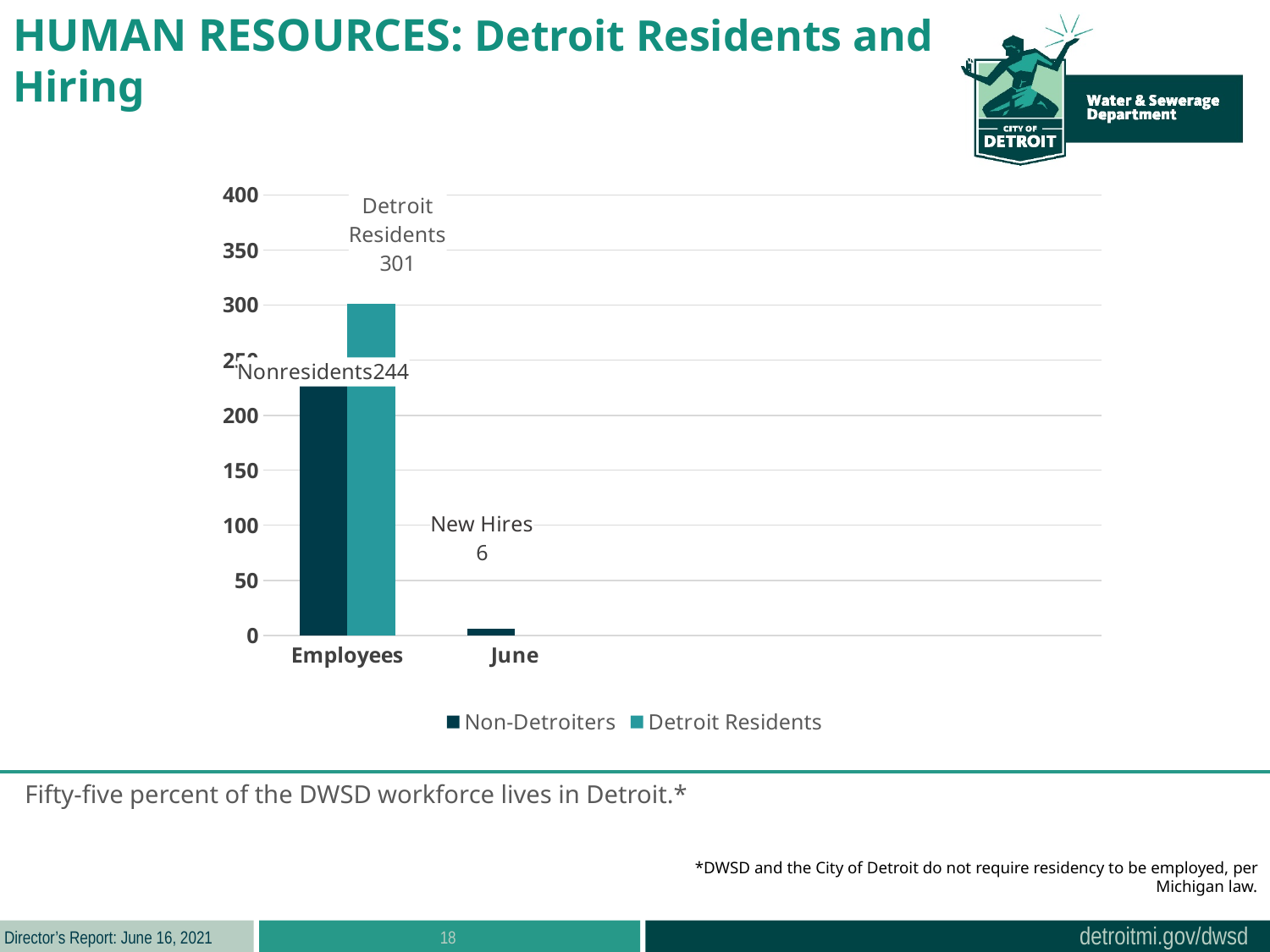
What are the two series named in the chart legend? Non-Detroiters and Detroit Residents Is the Nonresidents value for Employees greater or less than 200? greater How many categories are shown on the x axis of the chart? 2 How many series does the chart legend list? 2 Which is larger for the Employees category: Detroit Residents or Nonresidents? Detroit Residents What is the difference between the Detroit Residents value (301) and the Nonresidents value (244) for Employees? 57 What is the value labelled Detroit Residents for the Employees category? 301 Which category has the lowest bar on the chart? June What is the value labelled New Hires for the June category? 6 Is the Detroit Residents value for Employees greater or less than 350? less What is the value labelled Nonresidents for the Employees category? 244 What kind of chart is shown on the slide? bar chart